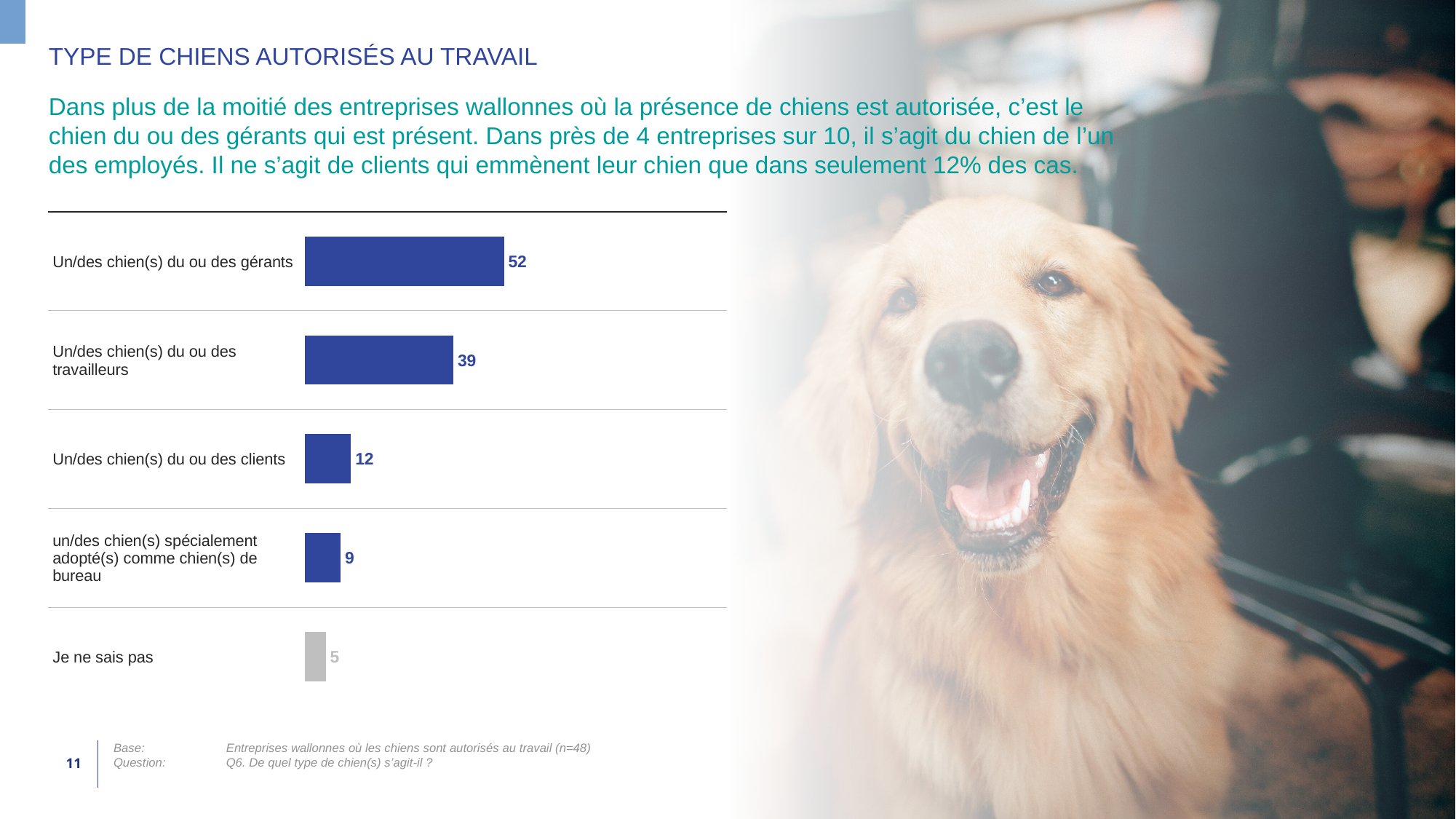
Which bar is shown in grey rather than blue? Je ne sais pas What is the difference between the values for "Un/des chien(s) du ou des gérants" and "Un/des chien(s) du ou des travailleurs"? 13 What kind of chart is shown on the slide? Bar chart Which category has the highest value? Un/des chien(s) du ou des gérants What is the value for "Un/des chien(s) du ou des gérants"? 52 Which is larger: the value for "Un/des chien(s) du ou des clients" or for "un/des chien(s) spécialement adopté(s) comme chien(s) de bureau"? Un/des chien(s) du ou des clients What is the value for "Un/des chien(s) du ou des clients"? 12 What is the difference between the values for "Un/des chien(s) du ou des clients" and "Je ne sais pas"? 7 What is the value for "Je ne sais pas"? 5 What is the value for "Un/des chien(s) du ou des travailleurs"? 39 How many categories are shown in the chart? 5 Which category has the lowest value? Je ne sais pas